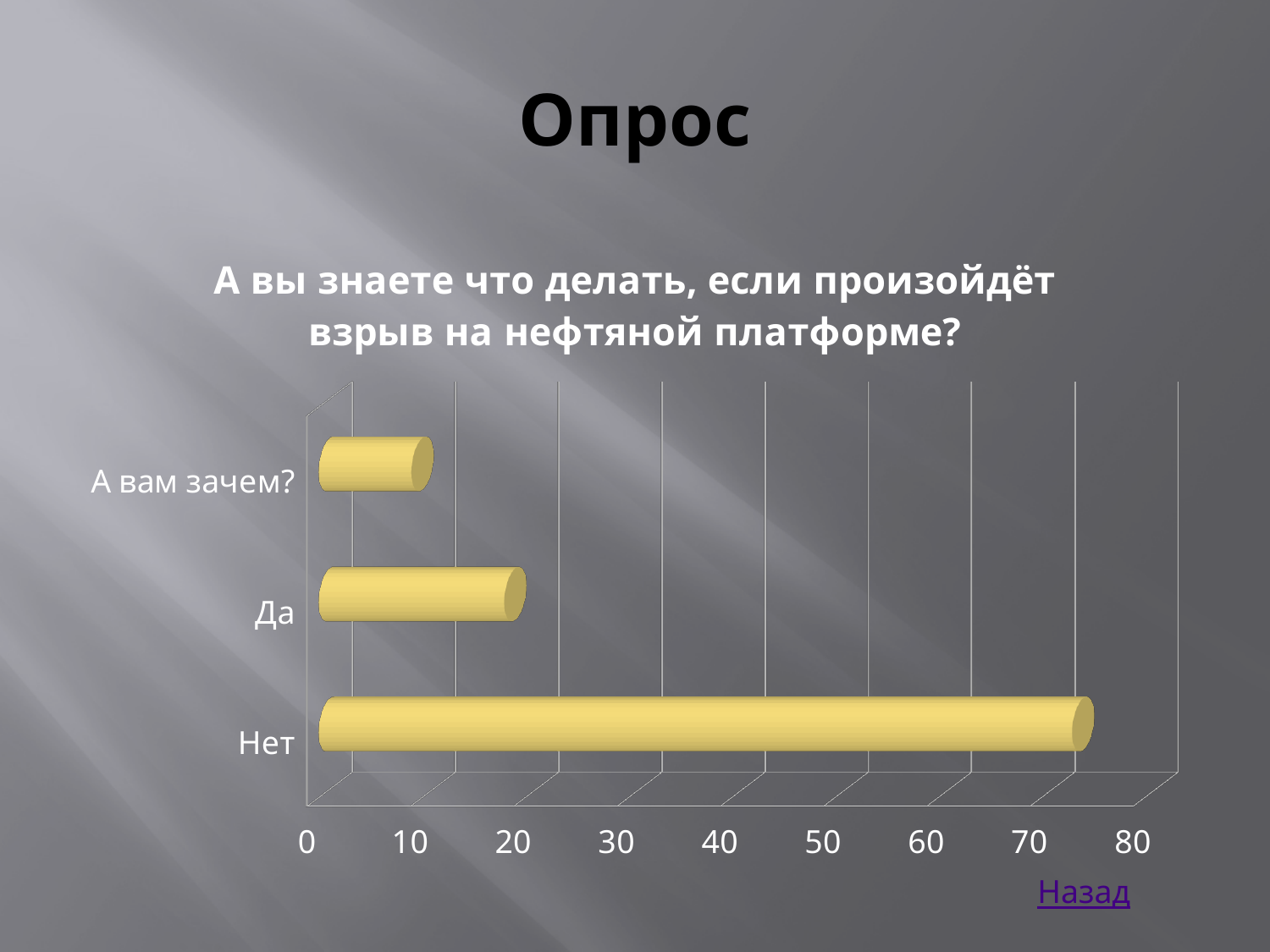
Is the value for Нет greater or less than 60? greater Which category has the highest value? Нет Which category has the lowest value? А вам зачем? Is the value for А вам зачем? greater or less than 20? less Which is larger, the value for Да or the value for А вам зачем? Да Is the value for Да greater or less than 30? less How many categories does the chart show? 3 What is the highest value shown on the horizontal axis? 80 What kind of chart is shown on the slide? bar chart Which is larger, the value for Да or the value for Нет? Нет What is the title of the chart? А вы знаете что делать, если произойдёт взрыв на нефтяной платформе?